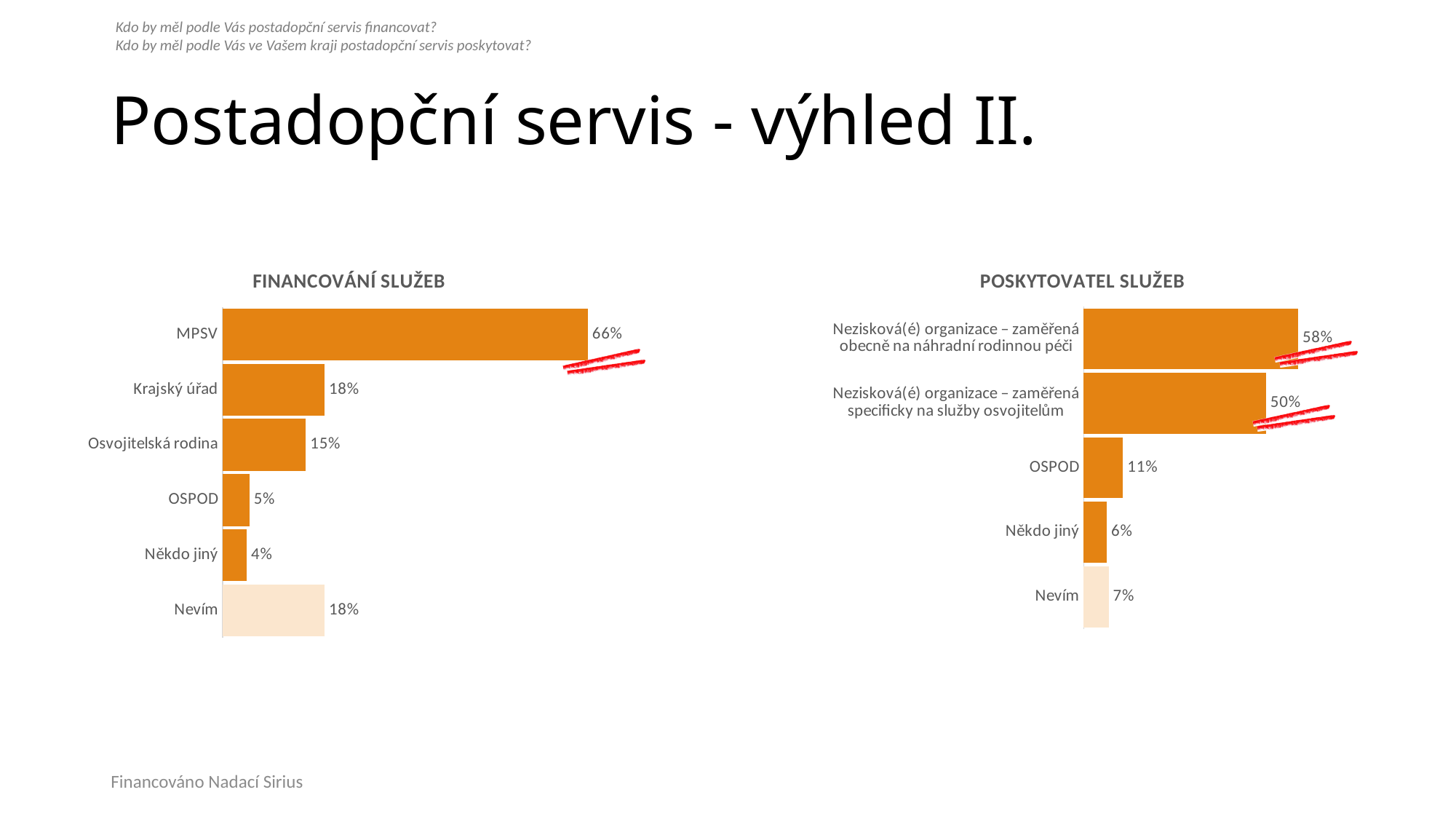
In the FINANCOVÁNÍ SLUŽEB chart, how many categories are shown? 6 In the POSKYTOVATEL SLUŽEB chart, how many categories are shown? 5 In the POSKYTOVATEL SLUŽEB chart, what is the difference between the two Nezisková(é) organizace categories? 8% In the FINANCOVÁNÍ SLUŽEB chart, which is larger, OSPOD or Někdo jiný? OSPOD In the POSKYTOVATEL SLUŽEB chart, which category has the highest value? Nezisková(é) organizace – zaměřená obecně na náhradní rodinnou péči In the POSKYTOVATEL SLUŽEB chart, what is the value for OSPOD? 11% In the POSKYTOVATEL SLUŽEB chart, what is the value for Nevím? 7% In the FINANCOVÁNÍ SLUŽEB chart, what is the value for Osvojitelská rodina? 15% In the FINANCOVÁNÍ SLUŽEB chart, what is the difference between MPSV and Krajský úřad? 48% In the FINANCOVÁNÍ SLUŽEB chart, what is the value for MPSV? 66% What type of chart is the POSKYTOVATEL SLUŽEB chart? Bar chart In the FINANCOVÁNÍ SLUŽEB chart, which category has the lowest value? Někdo jiný